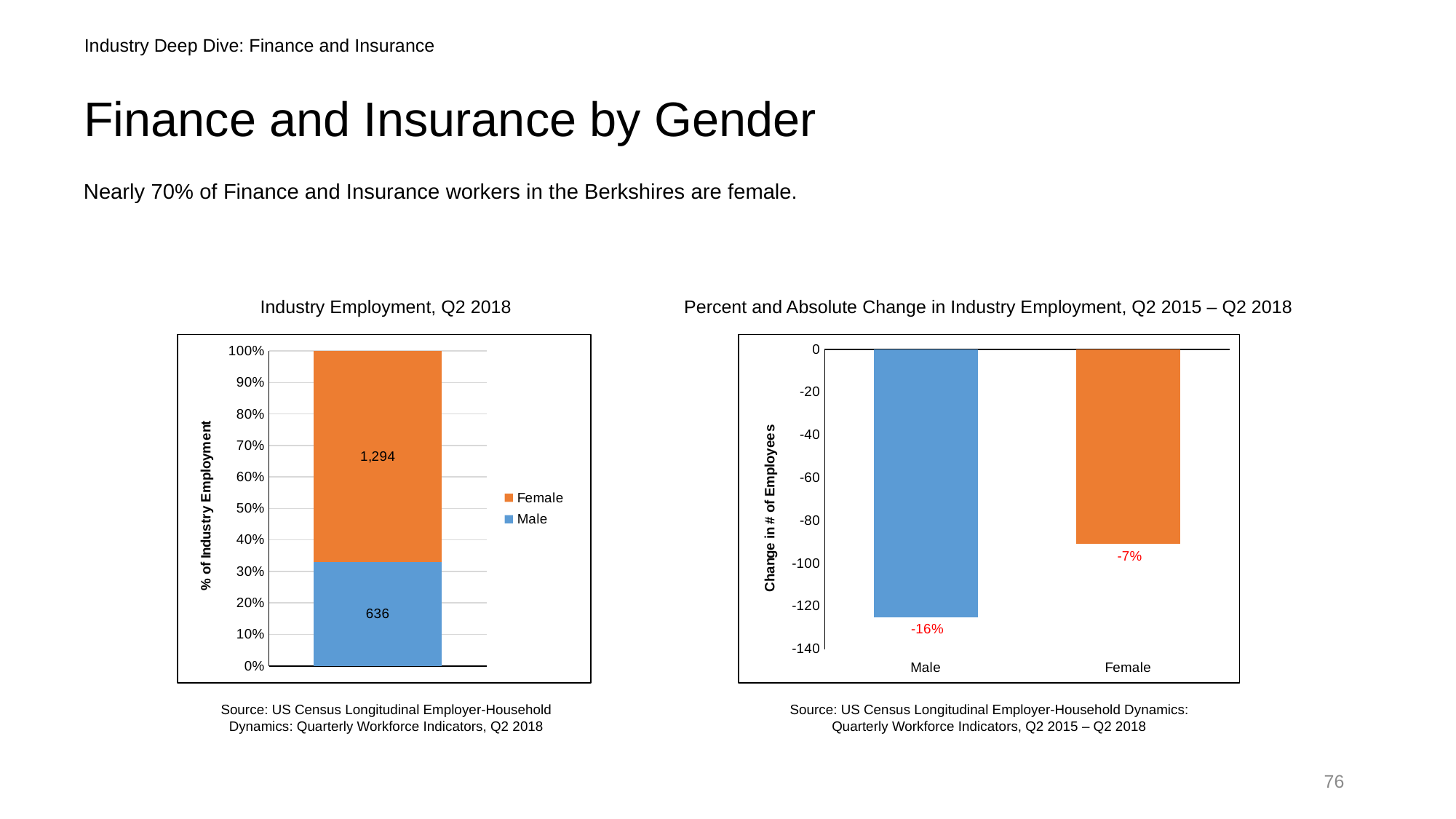
In the 'Industry Employment, Q2 2018' chart, what is the difference between the Female and Male values? 658 In the 'Percent and Absolute Change in Industry Employment, Q2 2015 – Q2 2018' chart, what percent change is labeled for Female? -7% In the 'Industry Employment, Q2 2018' chart, what is the value shown for Female? 1,294 In the 'Percent and Absolute Change in Industry Employment, Q2 2015 – Q2 2018' chart, what percent change is labeled for Male? -16% In the 'Industry Employment, Q2 2018' chart, what is the total of the Female and Male values in the stacked bar? 1,930 In the 'Percent and Absolute Change in Industry Employment, Q2 2015 – Q2 2018' chart, is the change in # of employees for Female greater or less than -100? greater In the 'Industry Employment, Q2 2018' chart, what is the value shown for Male? 636 How many series does the legend of the 'Industry Employment, Q2 2018' chart list? 2 In the 'Percent and Absolute Change in Industry Employment, Q2 2015 – Q2 2018' chart, is the change in # of employees for Male greater or less than -120? less What kind of chart is the 'Industry Employment, Q2 2018' chart? Stacked bar chart In the 'Percent and Absolute Change in Industry Employment, Q2 2015 – Q2 2018' chart, which category has the lowest (most negative) change in # of employees? Male In the 'Industry Employment, Q2 2018' chart, which is larger, the Female value or the Male value? Female